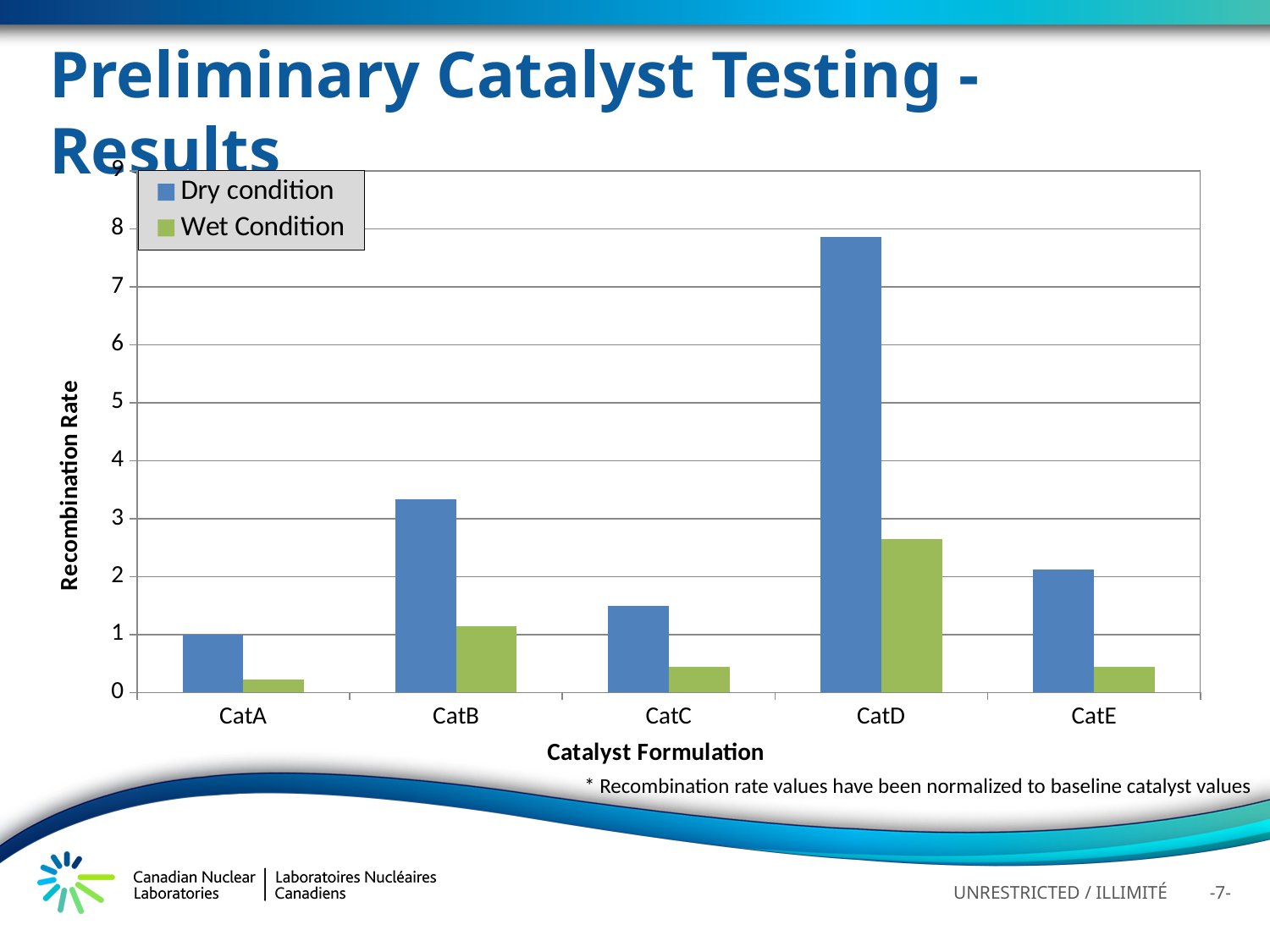
How many catalyst formulations are shown on the x axis? 5 Is the dry condition value for CatB greater or less than 3? greater Which catalyst formulation has the highest recombination rate under wet condition? CatD What is the title of the y axis? Recombination Rate What kind of chart is shown on the slide? bar chart How many series does the legend list? 2 Is the wet condition value for CatA greater or less than 1? less Which catalyst formulation has the lowest recombination rate under wet condition? CatA Is the dry condition value for CatD greater or less than 7? greater Under dry condition, which has the larger recombination rate, CatB or CatC? CatB Which catalyst formulation has the highest recombination rate under dry condition? CatD